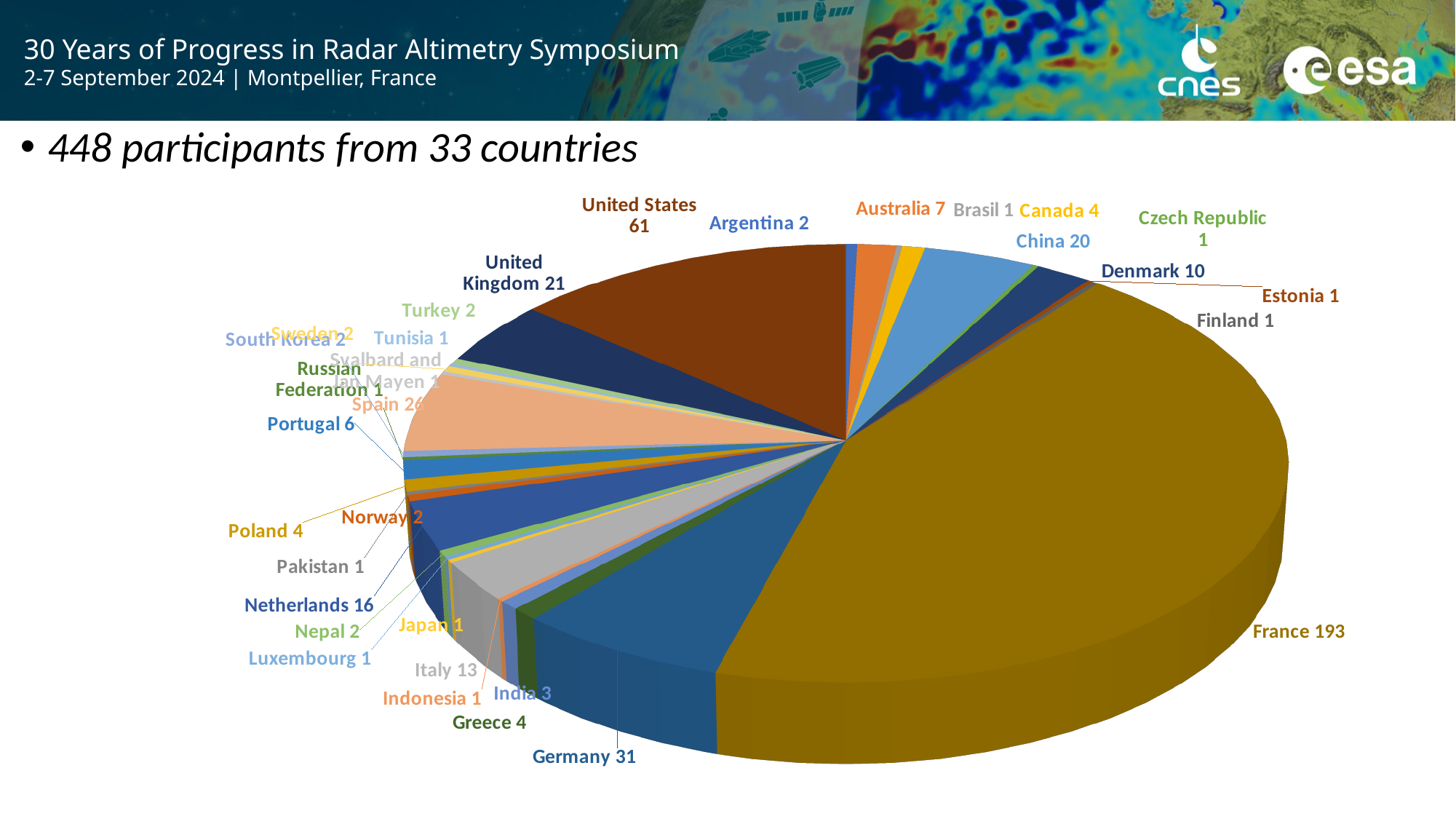
What is the difference in participants between Germany and Spain? 5 Which country has the largest slice of the pie chart? France How many participants came from the United States? 61 What is the difference in participants between France and the United States? 132 How many participants came from the Netherlands? 16 What type of chart is shown on the slide? pie chart Which has more participants, China or the United Kingdom? United Kingdom What is the total number of participants stated on the slide? 448 How many participants came from Germany? 31 How many participants came from France according to the pie chart? 193 How many participants came from Australia? 7 Which has more participants, Italy or Denmark? Italy